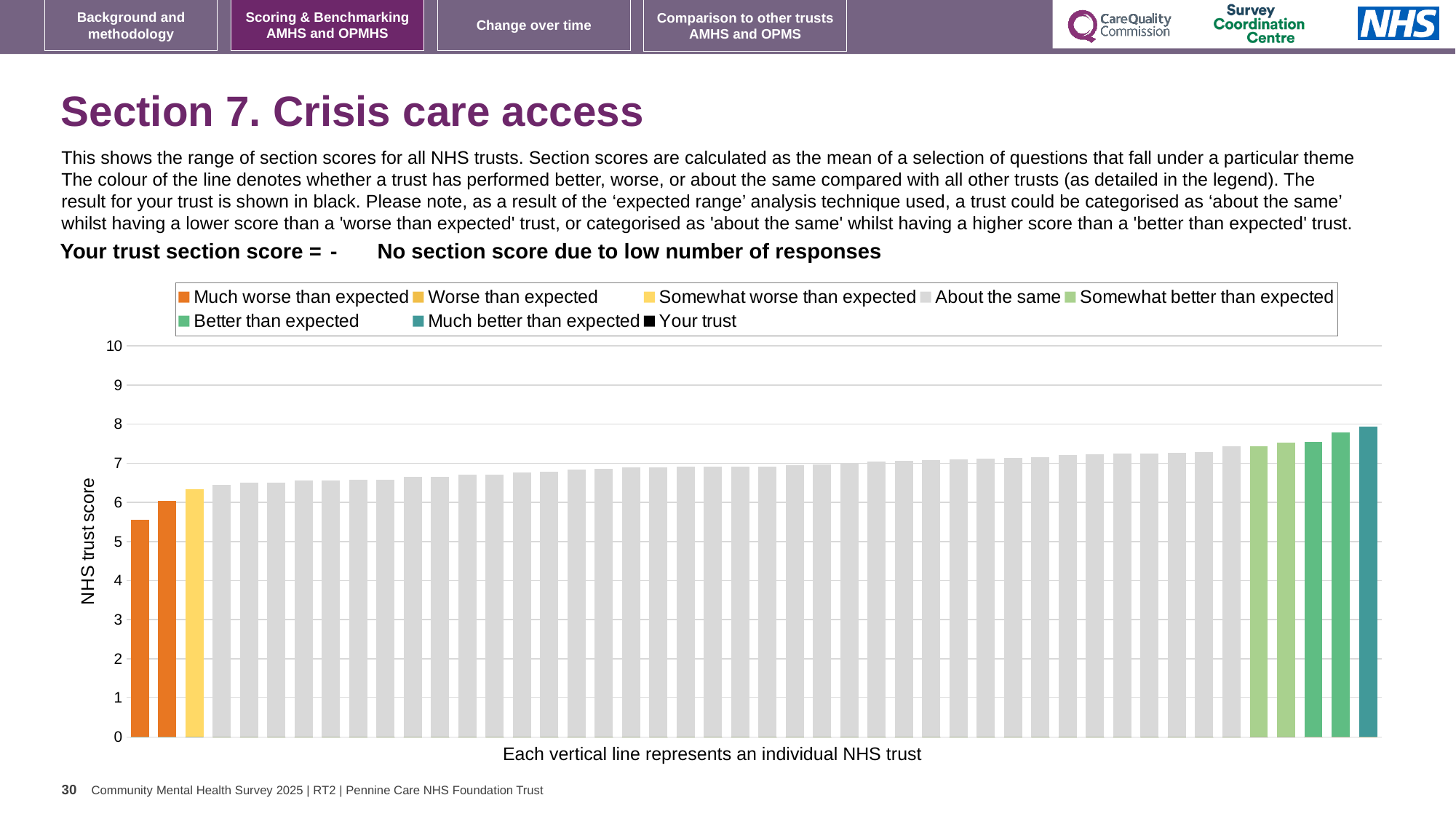
How many entries does the chart legend list? 8 Is the value of the leftmost (lowest) bar greater or less than 5? greater How many bars are coloured teal (Much better than expected)? 1 What is the maximum value shown on the vertical axis? 10 What does each vertical line in the chart represent, according to the x-axis caption? An individual NHS trust How many bars are coloured orange (Much worse than expected)? 2 Is the value of the rightmost (highest) bar greater or less than 7? greater What is the label on the vertical axis of the chart? NHS trust score Do the bar values rise or fall from left to right along the x axis? Rise What is the trust section score stated on the slide for your trust? No section score due to low number of responses Is the value of the leftmost (lowest) bar greater or less than 6? less What kind of chart is shown on the slide? Bar chart